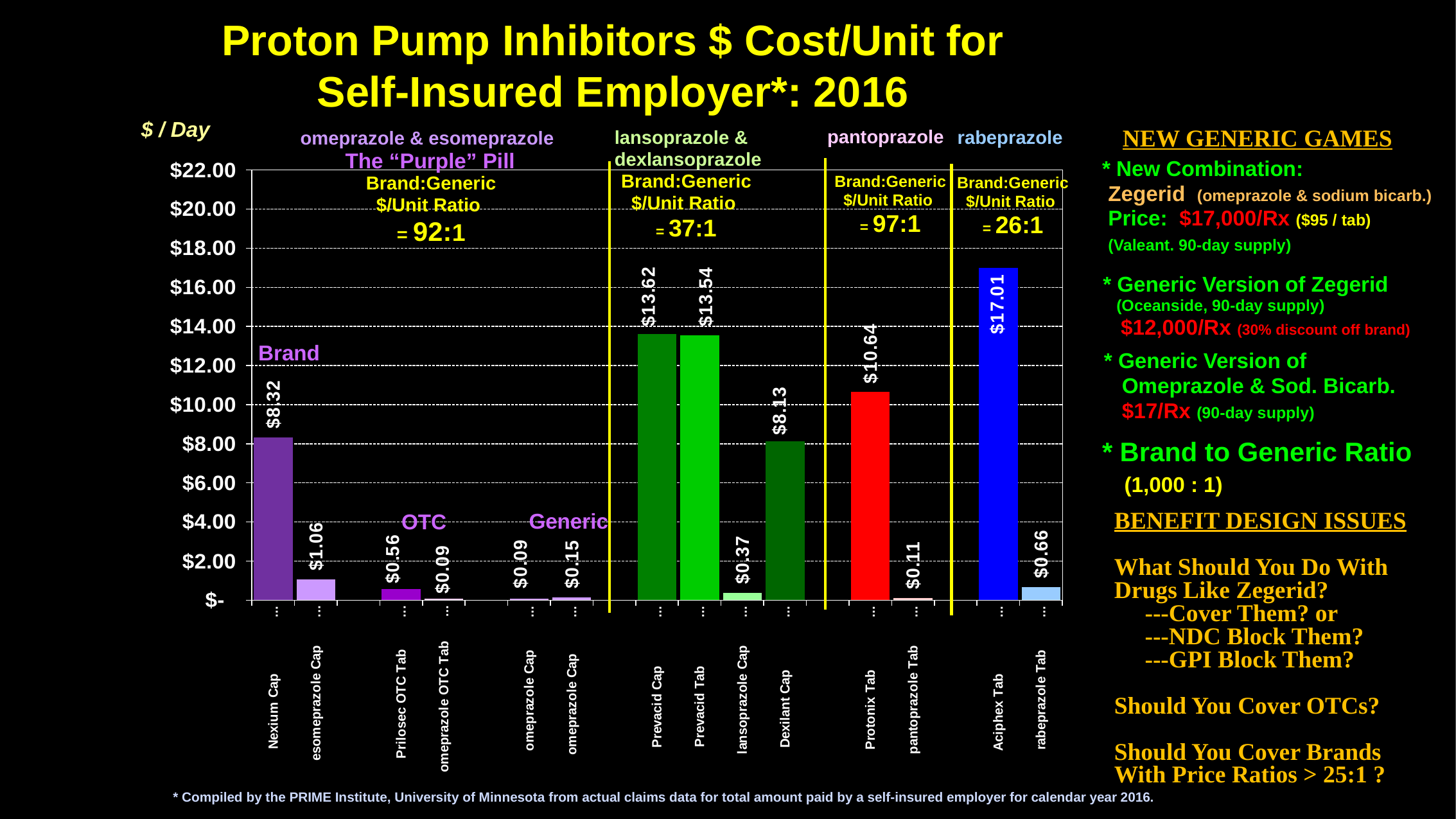
Which has a higher $/Day cost, Prevacid Cap or Dexilant Cap? Prevacid Cap Is the $/Day cost for Protonix Tab greater or less than $10.00? greater What kind of chart is shown on the slide? bar chart Which product has the highest $/Day cost on the chart? Aciphex Tab What is the $/Day cost for Nexium Cap? $8.32 What is the difference in $/Day cost between Nexium Cap and esomeprazole Cap? $7.26 What is the $/Day cost for Dexilant Cap? $8.13 What is the $/Day cost for Aciphex Tab? $17.01 How many bars are plotted on the chart? 14 What Brand:Generic $/Unit Ratio is shown for pantoprazole? 97:1 What is the difference in $/Day cost between Protonix Tab and pantoprazole Tab? $10.53 What is the $/Day cost for pantoprazole Tab? $0.11